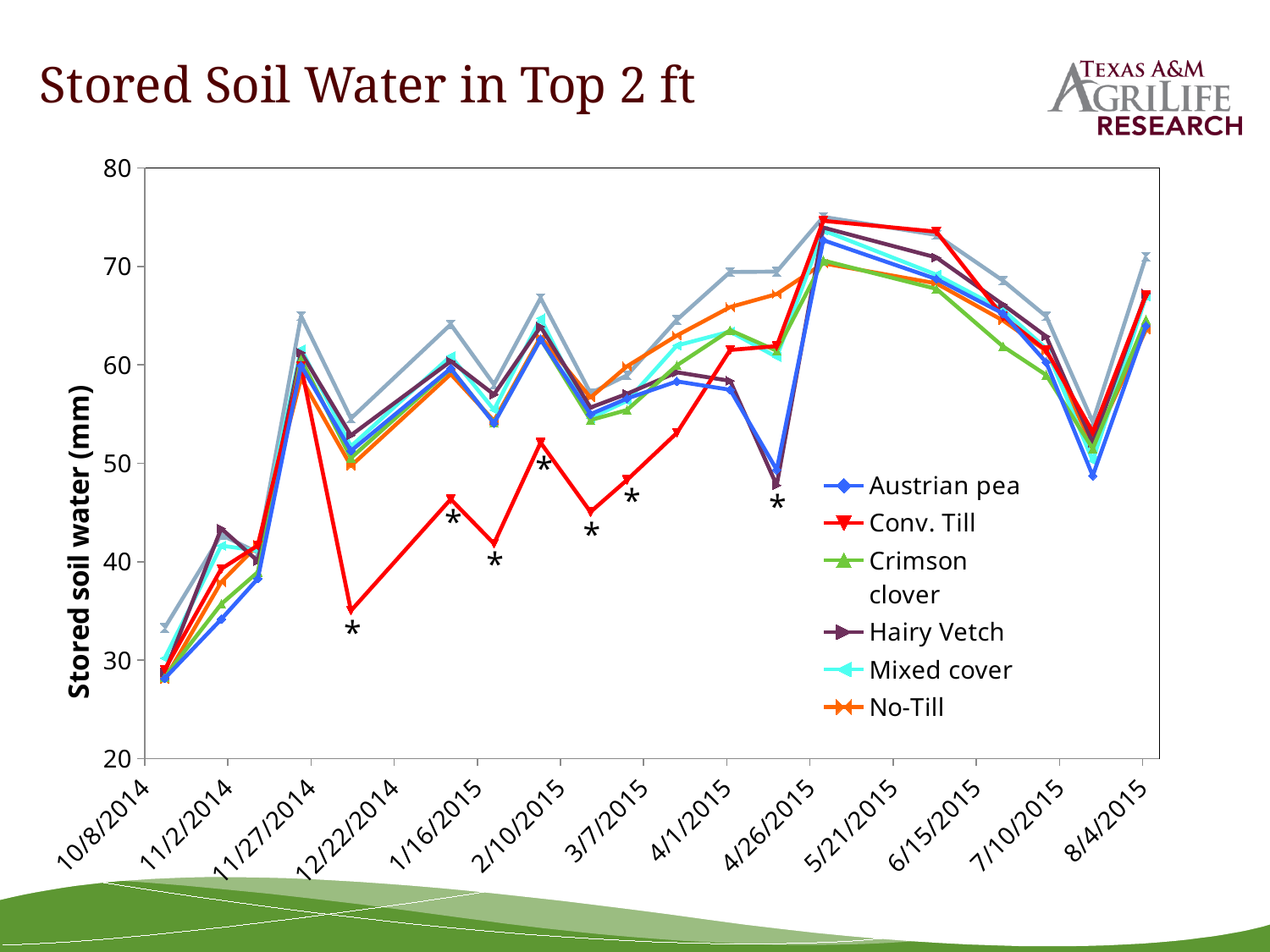
Is the lowest point of the Conv. Till line greater or less than 40? less What kind of chart is shown on the slide? line chart What is the title of the chart? Stored Soil Water in Top 2 ft Around 4/26/2015, which series is higher, Conv. Till or Austrian pea? Conv. Till Does the Conv. Till line rise or fall between 11/27/2014 and 12/22/2014? fall Which series drops to the lowest value on the chart, around late December 2014? Conv. Till Is the last (8/4/2015) value for Austrian pea greater or less than 60? greater How many series does the legend list? 6 Is the first (10/8/2014) value for Austrian pea greater or less than 30? less How many x-axis date labels are shown? 13 What is the label on the vertical axis? Stored soil water (mm)